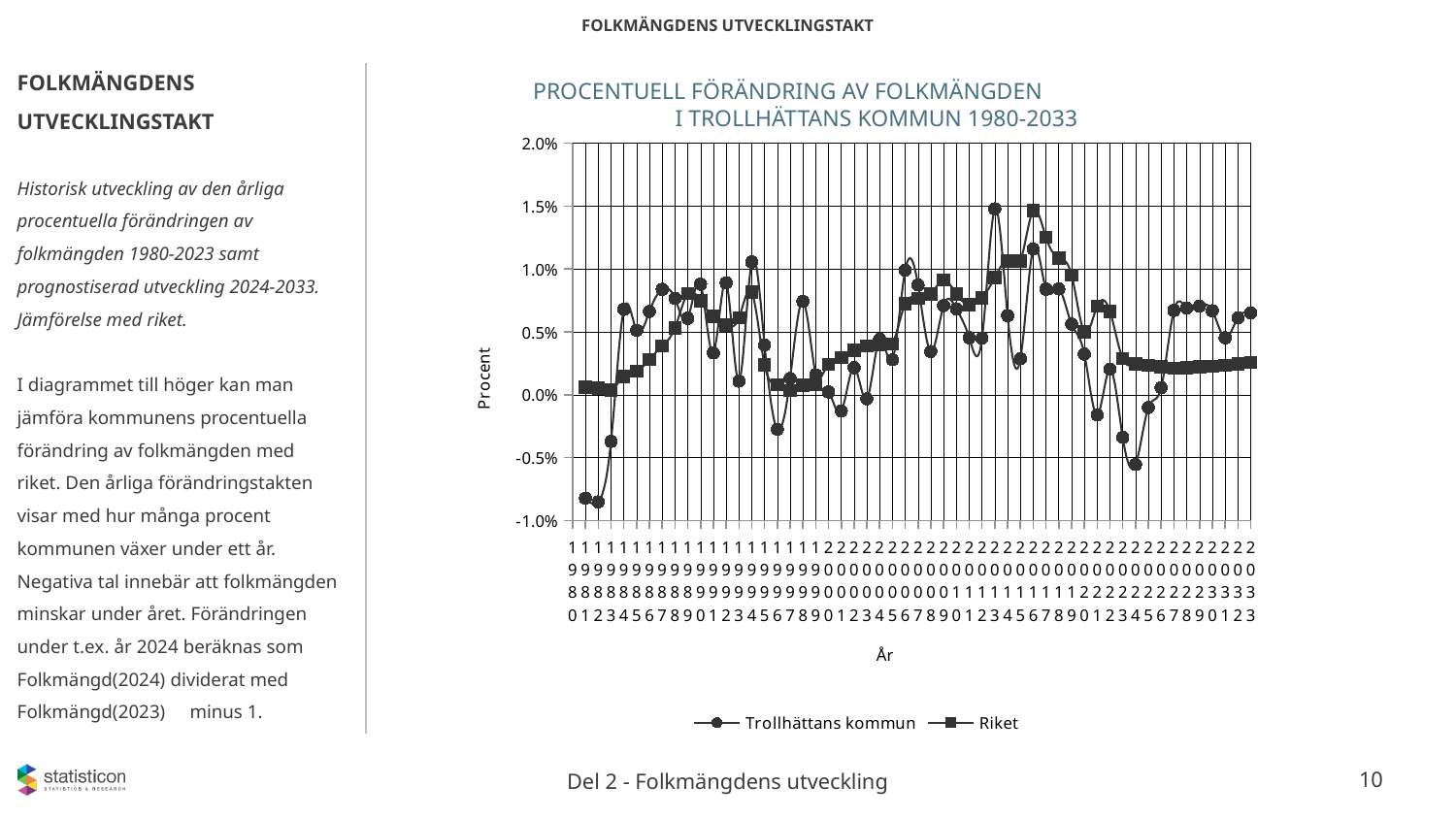
How many years (data points) does the x axis cover, from 1980 to 2033? 54 What is the title of the chart? PROCENTUELL FÖRÄNDRING AV FOLKMÄNGDEN I TROLLHÄTTANS KOMMUN 1980-2033 Which series reaches the lowest value anywhere on the chart? Trollhättans kommun How many series does the legend list? 2 Is the value for Riket in 2033 greater or less than 0.5%? less In 2033, which series has the higher value, Trollhättans kommun or Riket? Trollhättans kommun What are the two series named in the legend? Trollhättans kommun and Riket Is the value for Trollhättans kommun in 2033 greater or less than 0.5%? greater What kind of chart is shown on the slide? Line chart